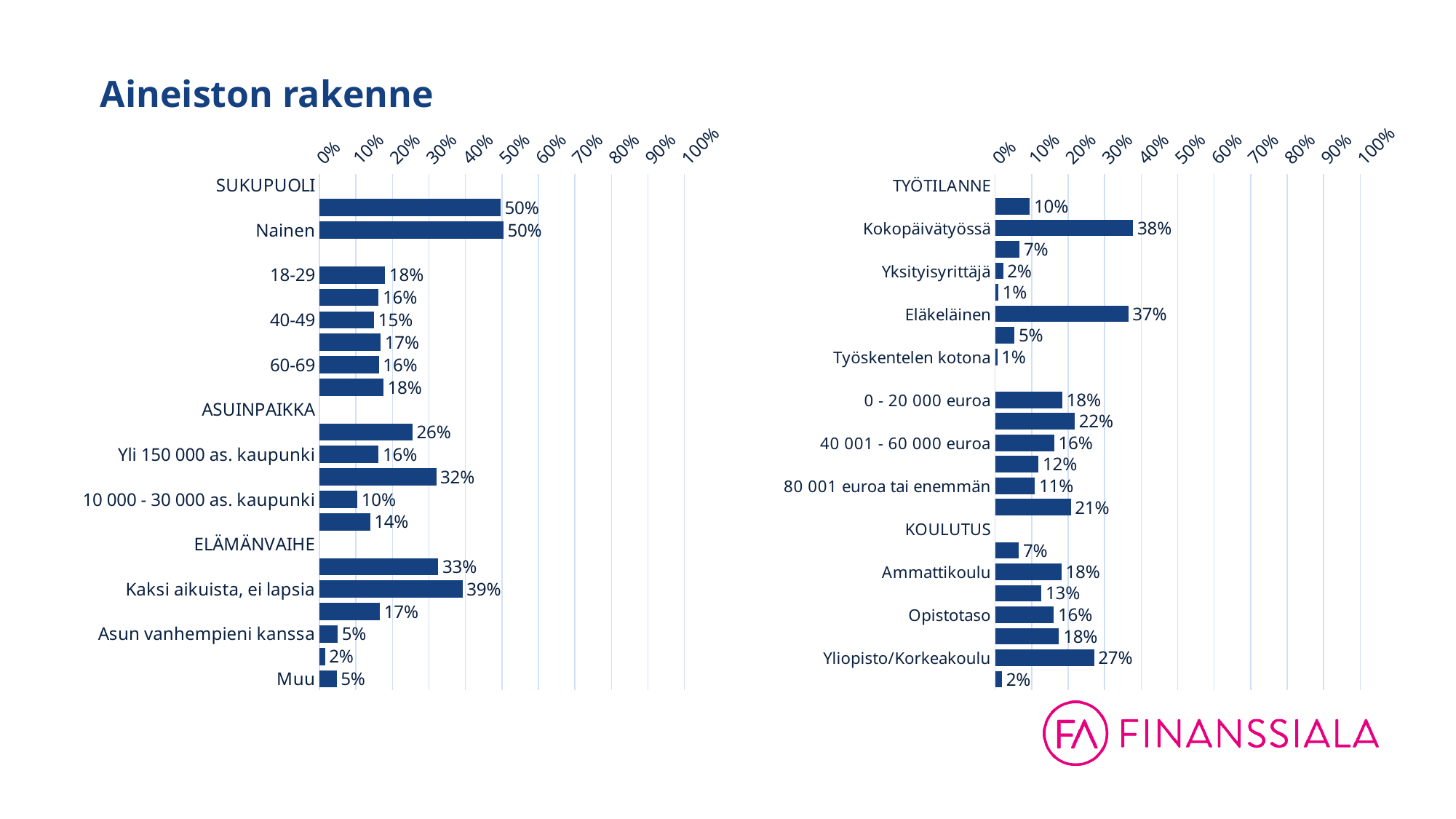
What is the title of the slide? Aineiston rakenne In the left chart, what is the value for Kaksi aikuista, ei lapsia? 39% In the left chart, which is larger: the value for 40-49 or the value for 60-69? 60-69 In the right chart, is the value for Eläkeläinen greater or less than 30%? greater In the left chart, what is the value for 18-29? 18% In the left chart, what is the value for Nainen? 50% What type of chart is shown on the left side of the slide? bar chart In the left chart, what is the difference between the values for Yli 150 000 as. kaupunki and 10 000 - 30 000 as. kaupunki? 6% In the right chart, what is the value for Työskentelen kotona? 1% In the right chart, what is the value for Yliopisto/Korkeakoulu? 27% In the right chart, what is the value for Kokopäivätyössä? 38% In the right chart, what is the difference between the values for 0 - 20 000 euroa and 80 001 euroa tai enemmän? 7%